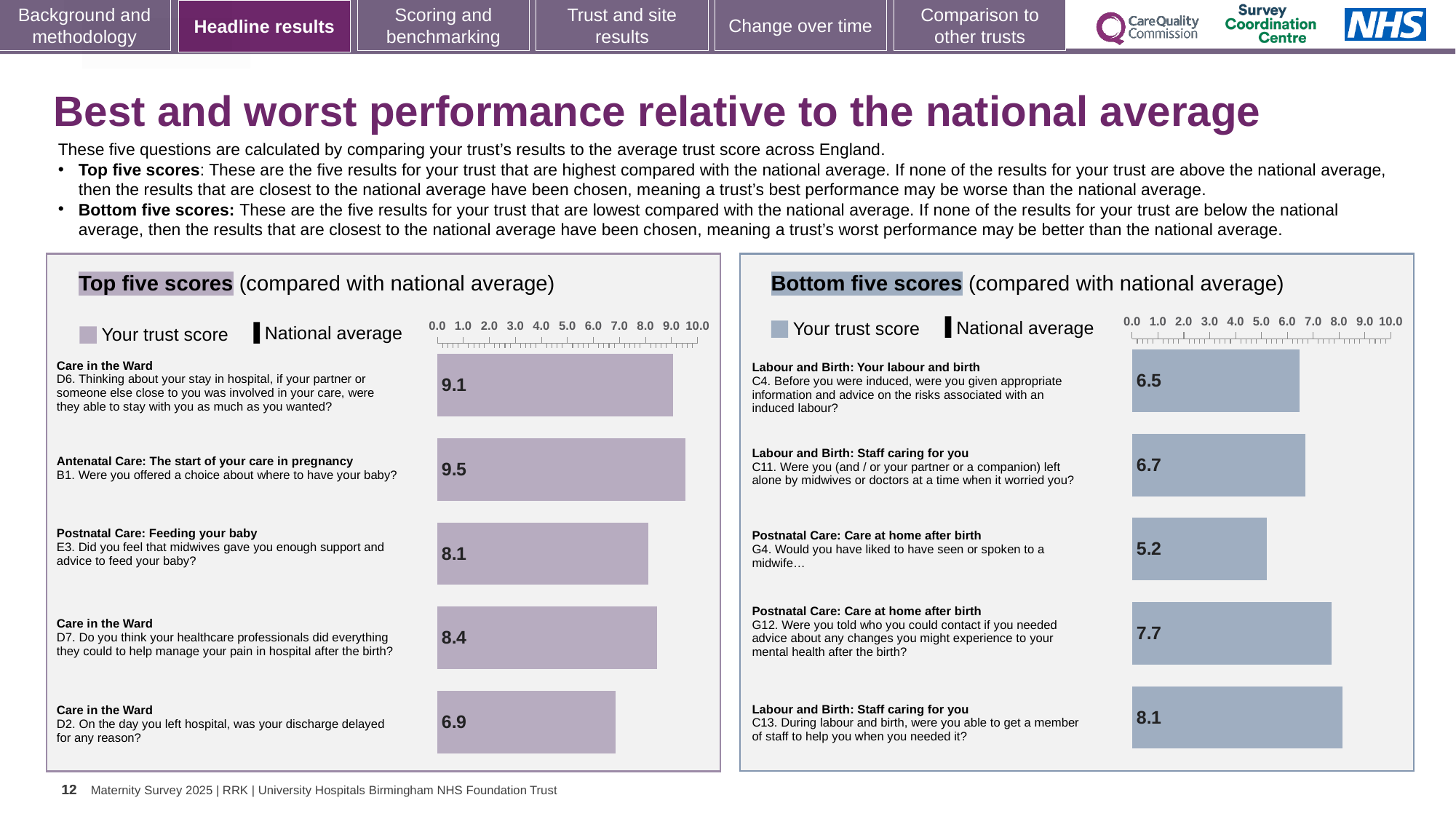
In the Bottom five scores chart, what is the trust score for C13 (During labour and birth, were you able to get a member of staff to help you when you needed it?)? 8.1 In the Top five scores chart, what is the difference between the trust scores for B1 and D2? 2.6 In the Top five scores chart, what is the trust score for D2 (On the day you left hospital, was your discharge delayed for any reason?)? 6.9 In the Top five scores chart, what is the trust score for B1 (Were you offered a choice about where to have your baby?)? 9.5 In the Bottom five scores chart, which question has the lowest trust score? G4 (Postnatal Care: seen or spoken to a midwife) In the Top five scores chart, which question has the highest trust score? B1 (Antenatal Care: choice about where to have your baby) In the Top five scores chart, which has the larger trust score: D6 or D7? D6 In the Bottom five scores chart, what is the trust score for G4 (Would you have liked to have seen or spoken to a midwife…)? 5.2 In the Top five scores chart, which question has the lowest trust score? D2 (Care in the Ward: discharge delayed) In the Bottom five scores chart, which question has the highest trust score? C13 (Labour and Birth: get a member of staff to help) What type of chart is used in the Bottom five scores panel? Bar chart In the Bottom five scores chart, what is the difference between the trust scores for C13 and G4? 2.9